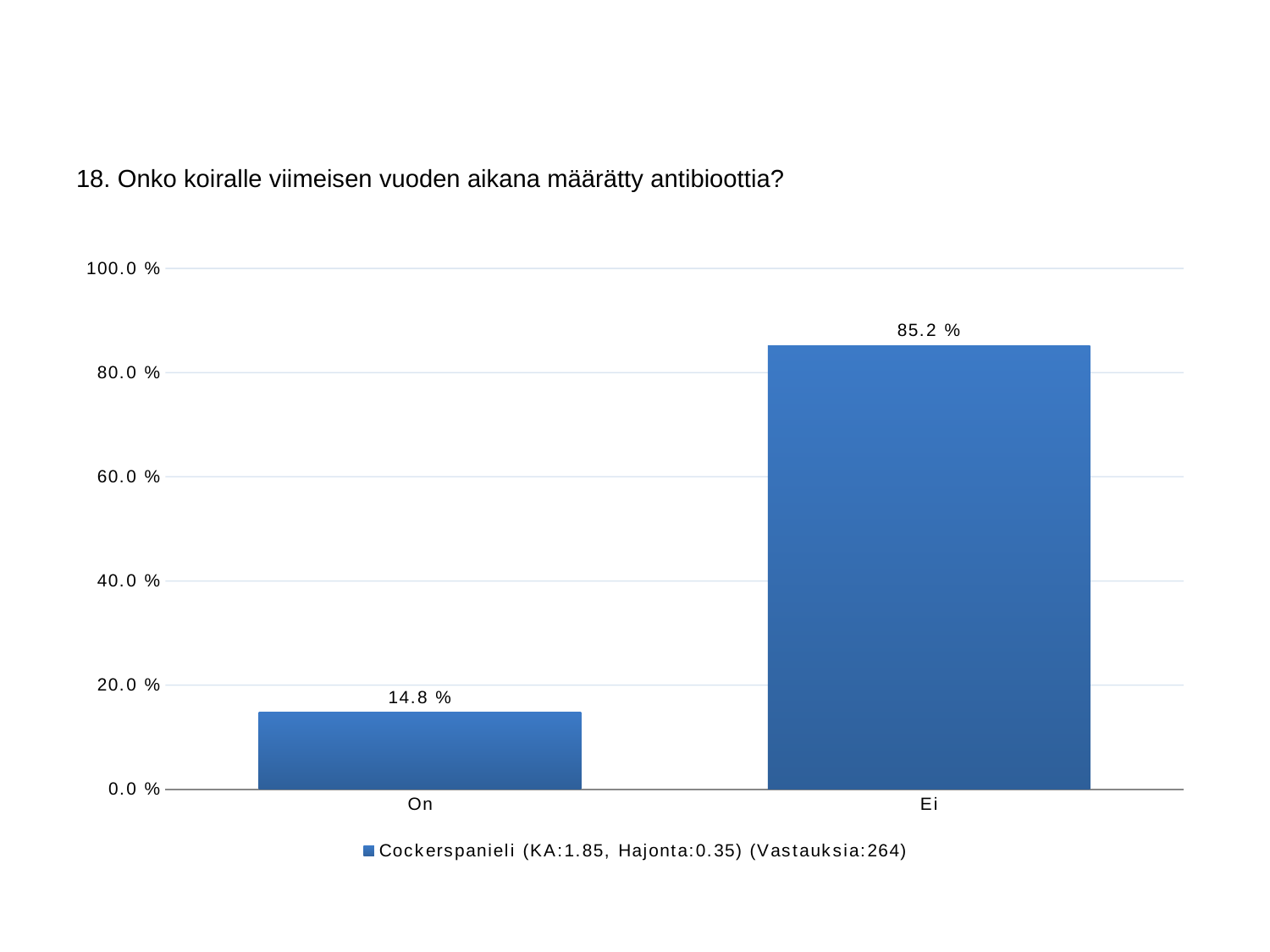
What is the difference between the values for "Ei" and "On"? 70.4 % What kind of chart is shown on the slide? bar chart Which category has the lowest value? On How many categories are shown on the x axis? 2 What is the value for "On"? 14.8 % Which is larger, the value for "On" or the value for "Ei"? Ei Is the value for "Ei" greater or less than 80.0 %? greater How many responses (Vastauksia) does the legend entry report? 264 How many series does the legend list? 1 What is the value for "Ei"? 85.2 % Is the value for "On" greater or less than 20.0 %? less Which category has the highest value? Ei